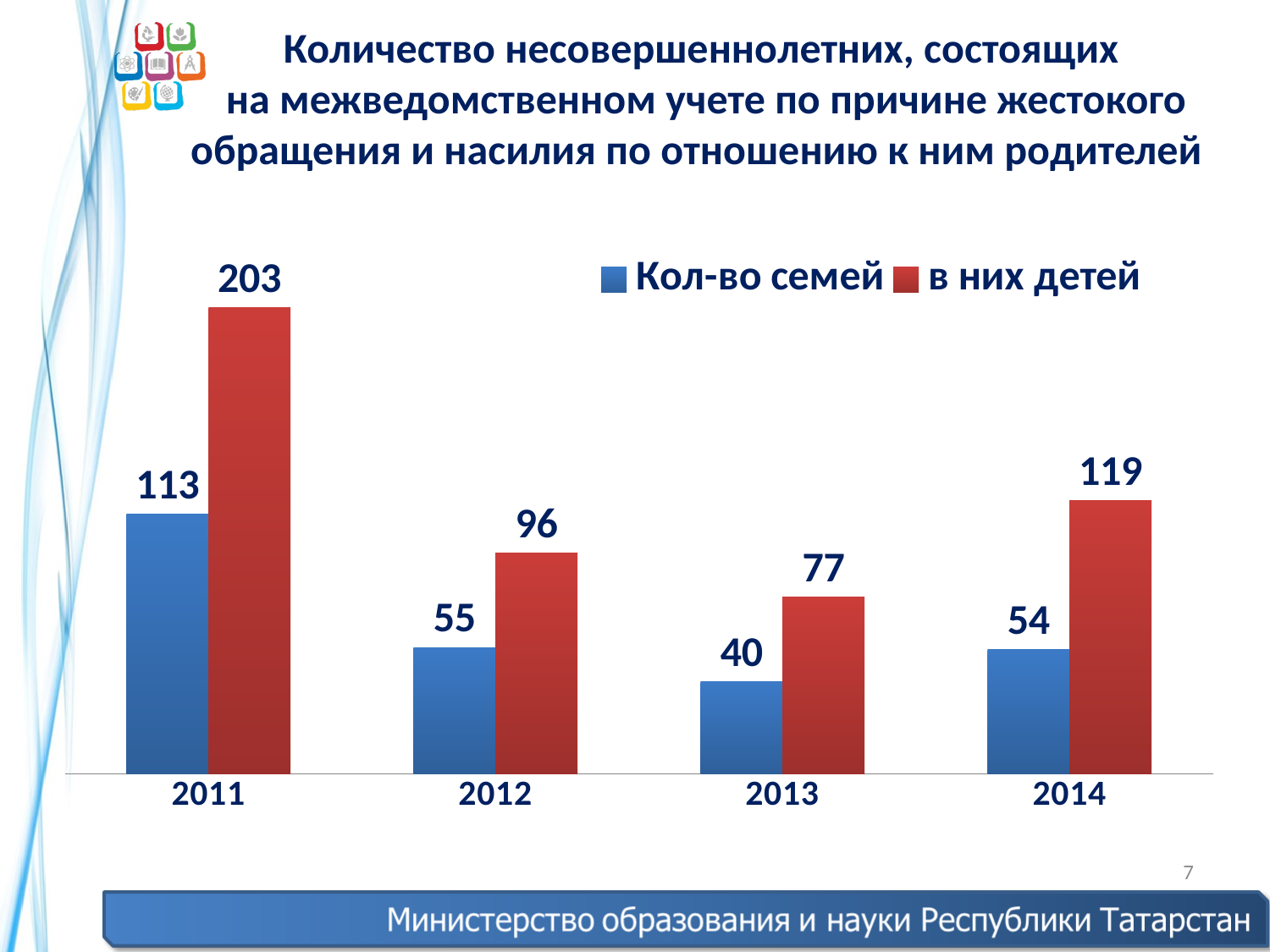
What is the value for "в них детей" in 2014? 119 What is the value for "Кол-во семей" in 2011? 113 Which year has the highest value for "в них детей"? 2011 How many years are shown on the x axis? 4 What is the value for "в них детей" in 2013? 77 Which is larger: "Кол-во семей" in 2012 or in 2014? 2012 What is the difference between "в них детей" and "Кол-во семей" in 2012? 41 How many series does the legend list? 2 What is the difference between the "в них детей" values for 2011 and 2014? 84 Which year has the lowest value for "Кол-во семей"? 2013 What kind of chart is shown on the slide? bar chart Which colour represents "в них детей" in the chart? red